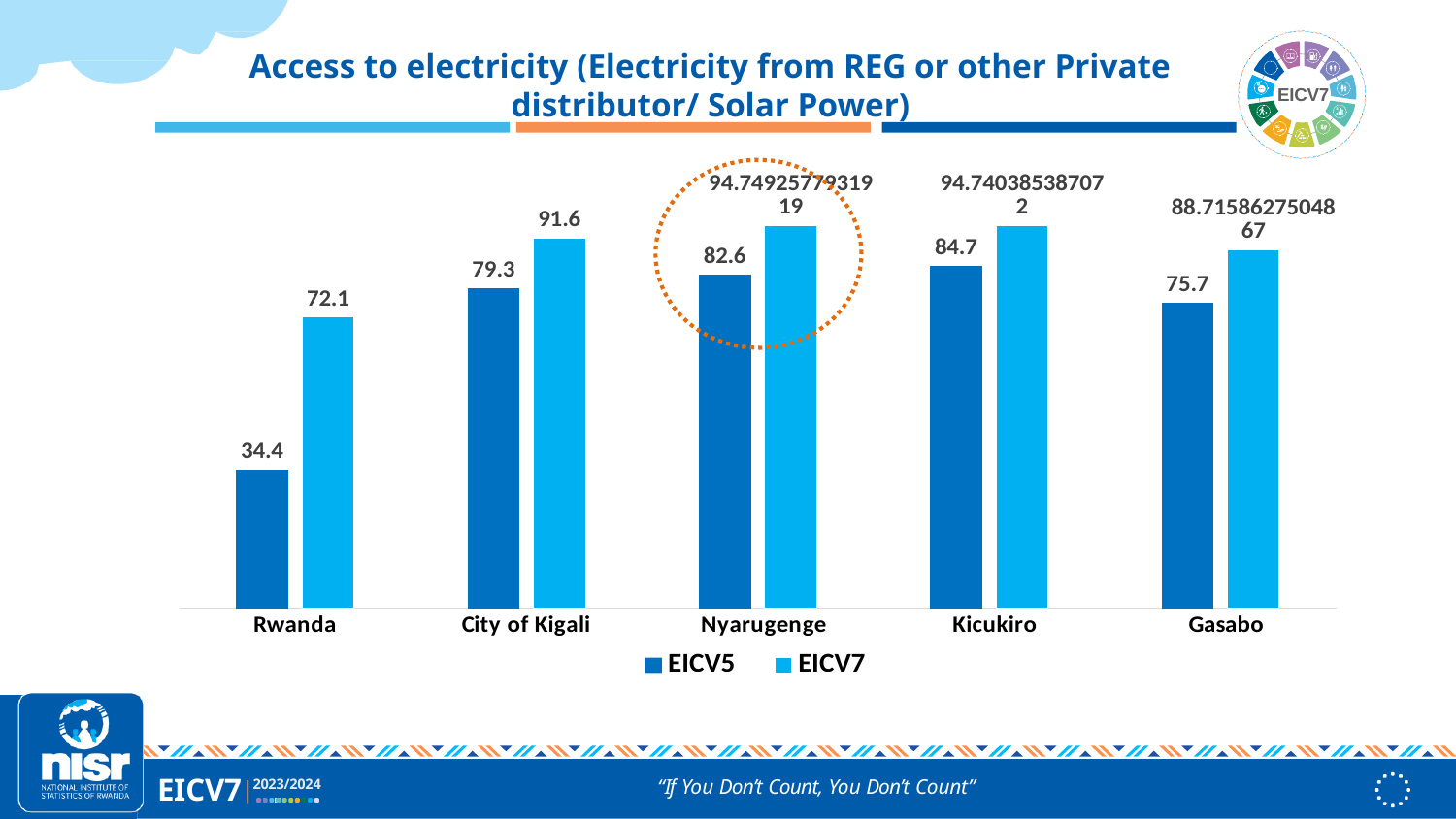
What is the EICV5 value for Kicukiro? 84.7 What is the difference between the EICV7 and EICV5 values for Rwanda? 37.7 What is the EICV7 value for City of Kigali? 91.6 How many series does the legend list? 2 How many categories are shown on the x axis? 5 What is the difference between the EICV7 and EICV5 values for City of Kigali? 12.3 Which category has the highest EICV5 value? Kicukiro Which category has the lowest EICV5 value? Rwanda Which is larger, the EICV5 value for Nyarugenge or the EICV5 value for Gasabo? Nyarugenge What is the EICV5 value for Gasabo? 75.7 What kind of chart is shown on the slide? bar chart What is the EICV5 value for Rwanda? 34.4